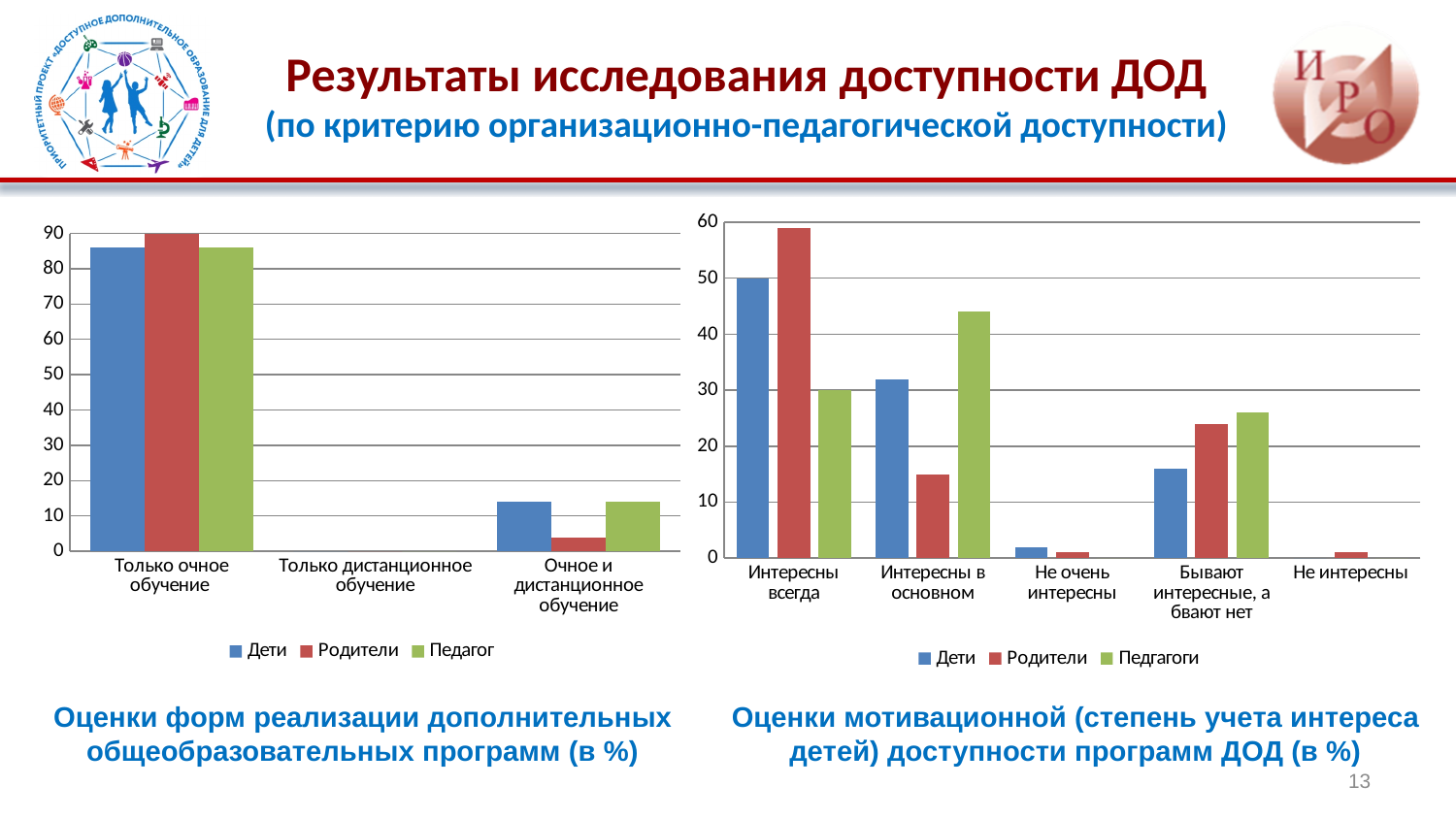
In the left chart, which series has the highest value for 'Только очное обучение'? Родители In the left chart, which category has the lowest values for all three series? Только дистанционное обучение In the left chart, how many categories are shown on the x axis? 3 In the left chart (Оценки форм реализации дополнительных общеобразовательных программ), what kind of chart is shown? bar chart In the right chart, which series has the highest value for 'Интересны всегда'? Родители In the left chart, how many series does the legend list? 3 In the right chart, which series has the highest value for 'Интересны в основном'? Педагоги In the right chart (Оценки мотивационной доступности программ ДОД), how many categories are shown on the x axis? 5 In the right chart, which is larger for 'Бывают интересные, а бвают нет': Дети or Родители? Родители In the left chart, is the value for Дети in 'Только очное обучение' greater or less than 80? greater In the left chart, is the value for Родители in 'Очное и дистанционное обучение' greater or less than 10? less In the right chart, is the value for Педагоги in 'Интересны в основном' greater or less than 40? greater